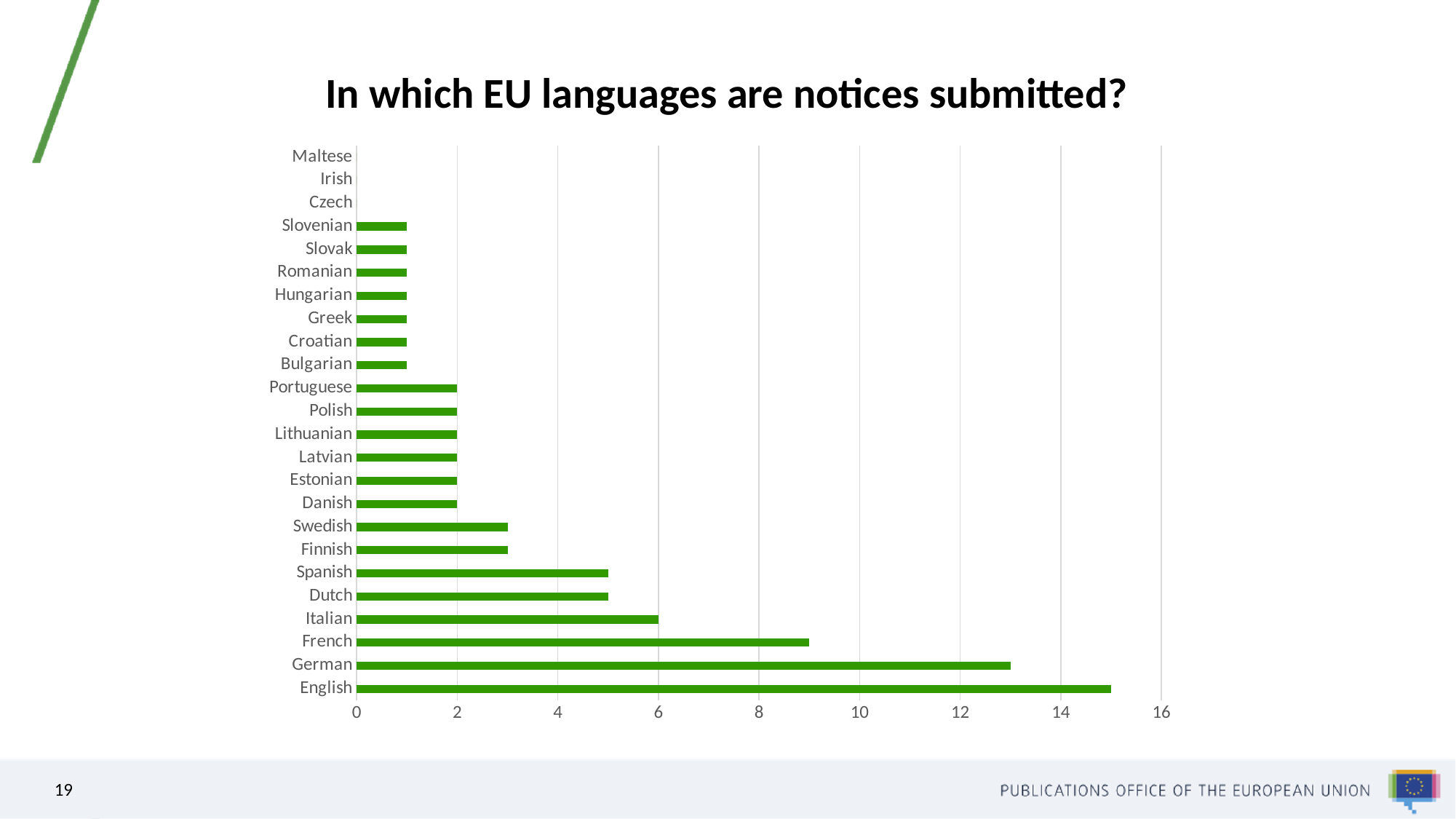
What is the value for Danish? 2 What is the value for Italian? 6 What kind of chart is shown on the slide? bar chart Which is larger, the value for German or the value for French? German Which language has the highest number of notices submitted? English What is the difference between the value for Italian and the value for Danish? 4 Is the value for French greater or less than 10? less Is the value for English greater or less than 14? greater Is the value for German greater or less than 12? greater What is the title of the chart? In which EU languages are notices submitted? How many languages are listed on the chart? 24 What is the value for Portuguese? 2